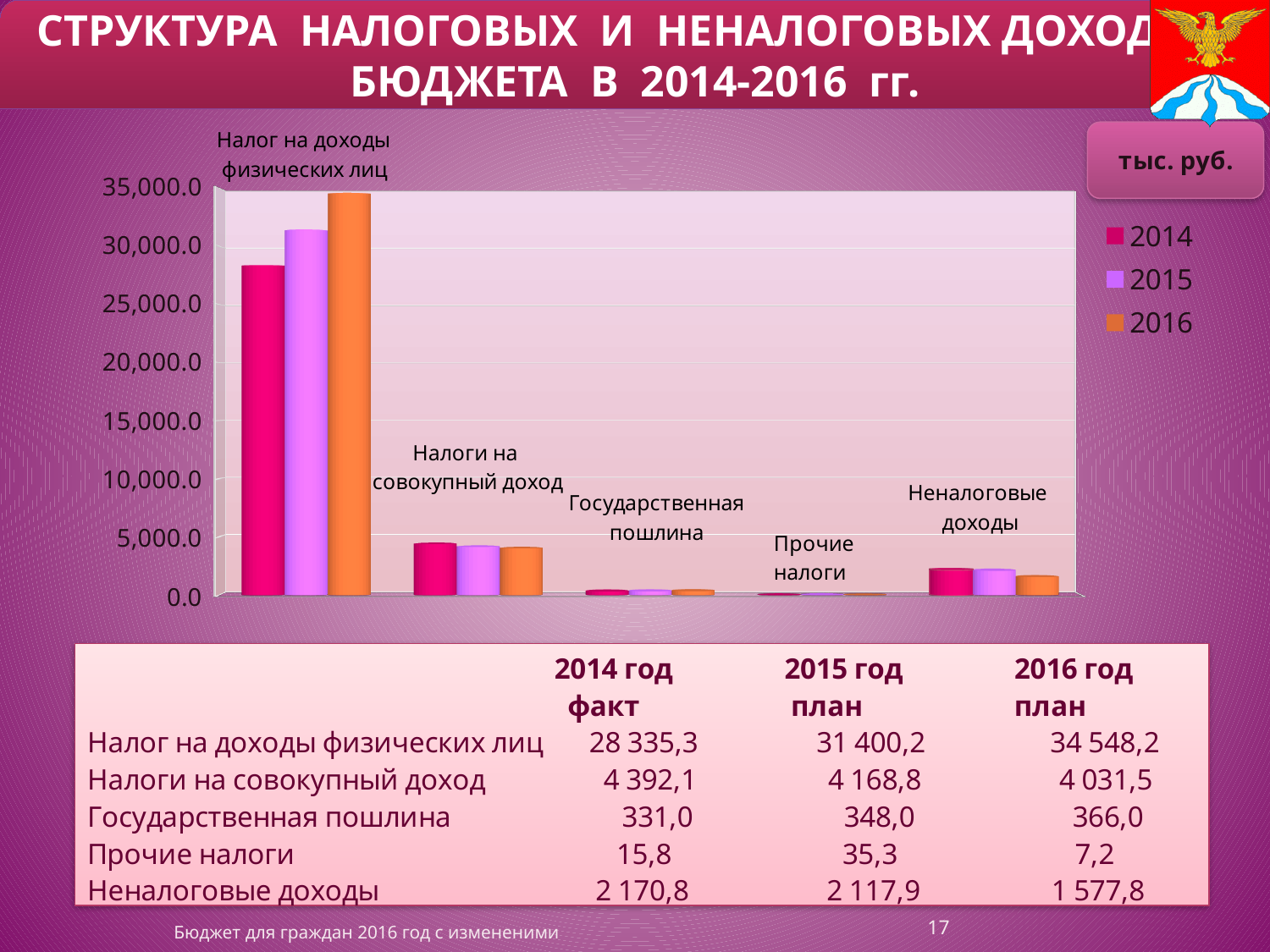
How many series does the chart legend list? 3 What kind of chart is shown on the slide? bar chart Do the values for Налог на доходы физических лиц rise or fall from 2014 to 2016? rise Which is larger for Налоги на совокупный доход: the 2014 value or the 2016 value? 2014 What is the value for Налог на доходы физических лиц in 2016? 34 548,2 Which category has the highest values on the chart? Налог на доходы физических лиц What is the value for Прочие налоги in 2015? 35,3 What is the value for Неналоговые доходы in 2014? 2 170,8 How many categories are plotted on the chart? 5 What is the difference between the 2016 and 2015 values for Государственная пошлина? 18,0 Is the 2014 value for Налог на доходы физических лиц greater or less than 25,000.0? greater Which category has the lowest values on the chart? Прочие налоги